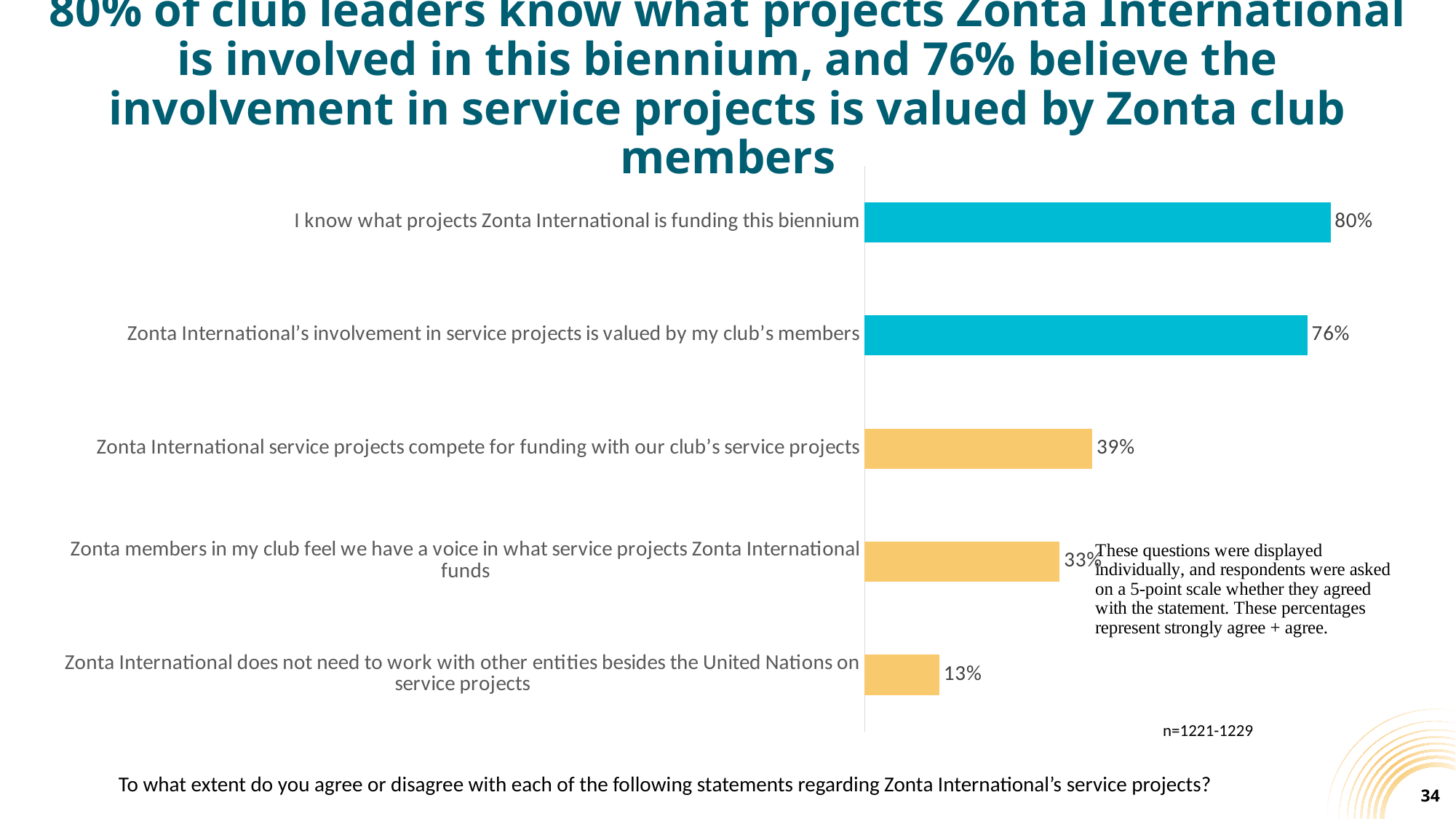
Which statement has the highest level of agreement? I know what projects Zonta International is funding this biennium What kind of chart is shown on the slide? Bar chart What percentage of club leaders agree with the statement "I know what projects Zonta International is funding this biennium"? 80% How many statements are shown in the chart? 5 Which is larger: the value for "Zonta International service projects compete for funding with our club's service projects" or the value for "Zonta members in my club feel we have a voice in what service projects Zonta International funds"? Zonta International service projects compete for funding with our club's service projects What is the difference between the value for "I know what projects Zonta International is funding this biennium" and the value for "Zonta International's involvement in service projects is valued by my club's members"? 4% What is the value for "Zonta International's involvement in service projects is valued by my club's members"? 76% What percentage agree that Zonta International service projects compete for funding with their club's service projects? 39% What is the value for "Zonta International does not need to work with other entities besides the United Nations on service projects"? 13% What is the difference between the value for the statement about competing for funding and the statement about members feeling they have a voice? 6% Which statement has the lowest level of agreement? Zonta International does not need to work with other entities besides the United Nations on service projects What colour are the bars for the two statements with the highest agreement? Blue